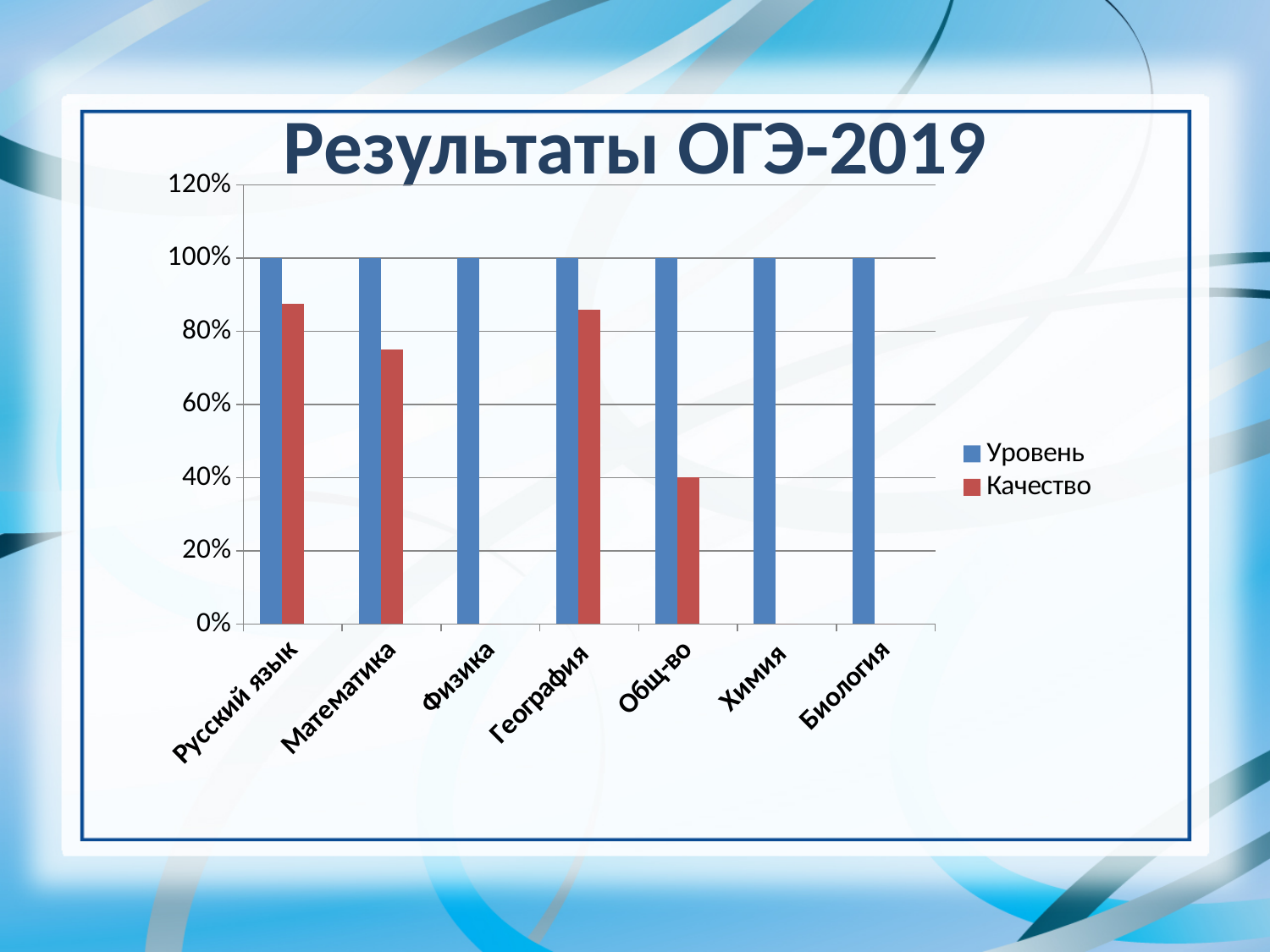
Which has the higher Качество value, Общ-во or География? География How many series does the legend list? 2 What is the title of the chart? Результаты ОГЭ-2019 What kind of chart is shown on the slide? bar chart Which has the higher Качество value, Русский язык or Математика? Русский язык What is the Уровень value for Химия? 100% Among the categories with a Качество bar, which has the lowest Качество value? Общ-во How many categories are shown on the x axis? 7 Is the Качество value for Математика greater or less than 80%? less What is the Уровень value for Русский язык? 100% Is the Качество value for Общ-во greater or less than 60%? less Is the Качество value for Русский язык greater or less than 80%? greater